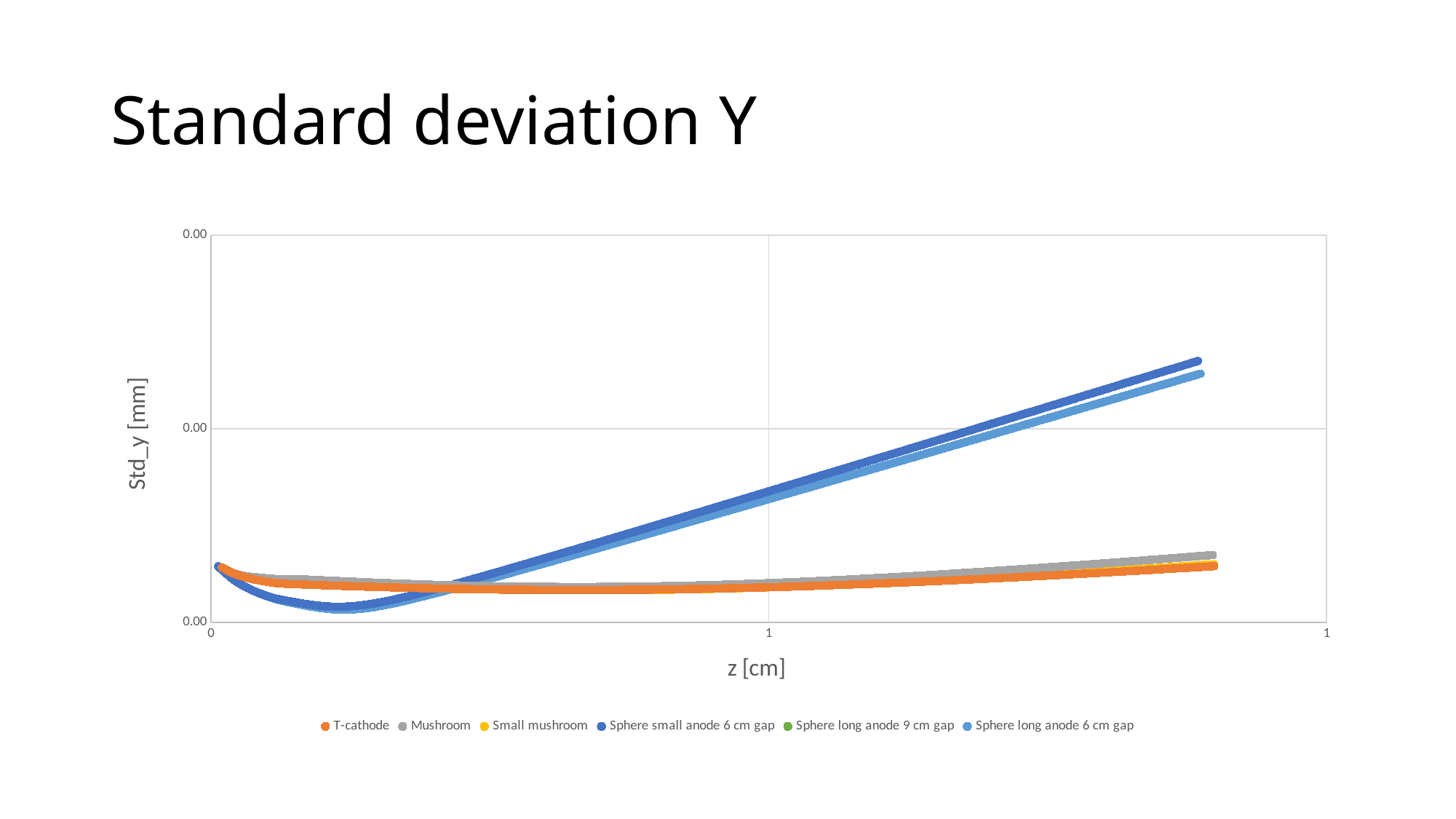
Does the Sphere small anode 6 cm gap series rise or fall over the right half of the x axis? rise How many series does the legend list? 6 At the right end of the chart, which is higher: Mushroom or T-cathode? Mushroom What kind of chart is shown on the slide? line chart At the right end of the chart, which is higher: Sphere long anode 6 cm gap or Mushroom? Sphere long anode 6 cm gap Which series has the lowest value at the right end of the chart? T-cathode Which series reaches the highest value at the right end of the chart? Sphere small anode 6 cm gap Does the Sphere long anode 6 cm gap series initially fall or rise just after z = 0? fall What is the label on the y axis? Std_y [mm] What is the title of the slide's chart? Standard deviation Y